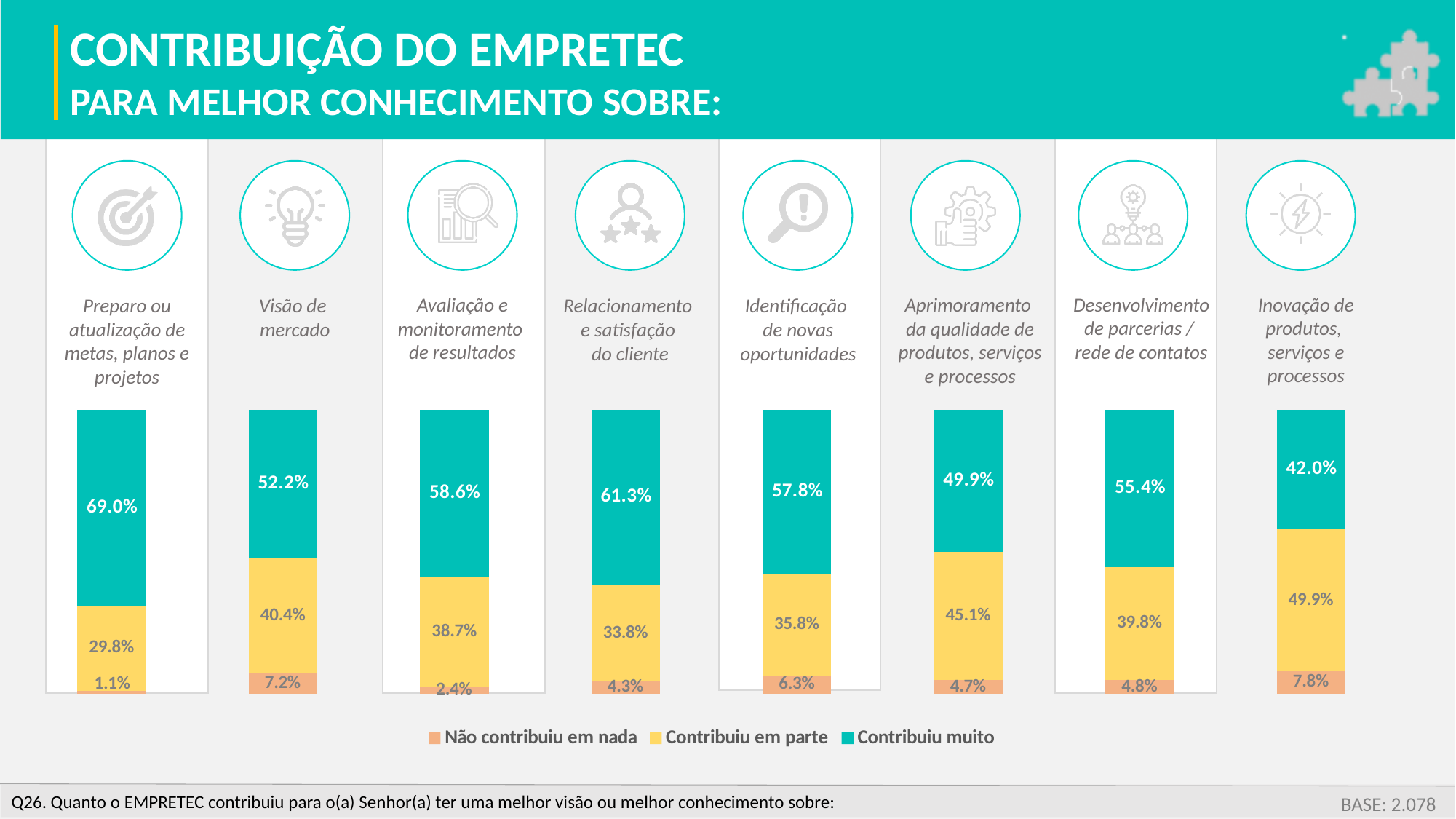
What is the difference in 'Contribuiu muito' between 'Preparo ou atualização de metas, planos e projetos' and 'Inovação de produtos, serviços e processos'? 27.0 percentage points Which colour represents 'Contribuiu muito' in the legend? Teal Which category has the highest 'Contribuiu muito' percentage? Preparo ou atualização de metas, planos e projetos How many categories are shown in the chart? 8 What is the 'Não contribuiu em nada' value for 'Visão de mercado'? 7.2% Which is larger: the 'Contribuiu muito' value for 'Relacionamento e satisfação do cliente' or for 'Identificação de novas oportunidades'? Relacionamento e satisfação do cliente What is the 'Contribuiu em parte' value for 'Inovação de produtos, serviços e processos'? 49.9% What percentage of respondents said EMPRETEC 'Contribuiu muito' for 'Preparo ou atualização de metas, planos e projetos'? 69.0% What type of chart is shown on the slide? Stacked bar chart How many series does the legend list? 3 Which category has the lowest 'Não contribuiu em nada' percentage? Preparo ou atualização de metas, planos e projetos Which category has the lowest 'Contribuiu muito' percentage? Inovação de produtos, serviços e processos